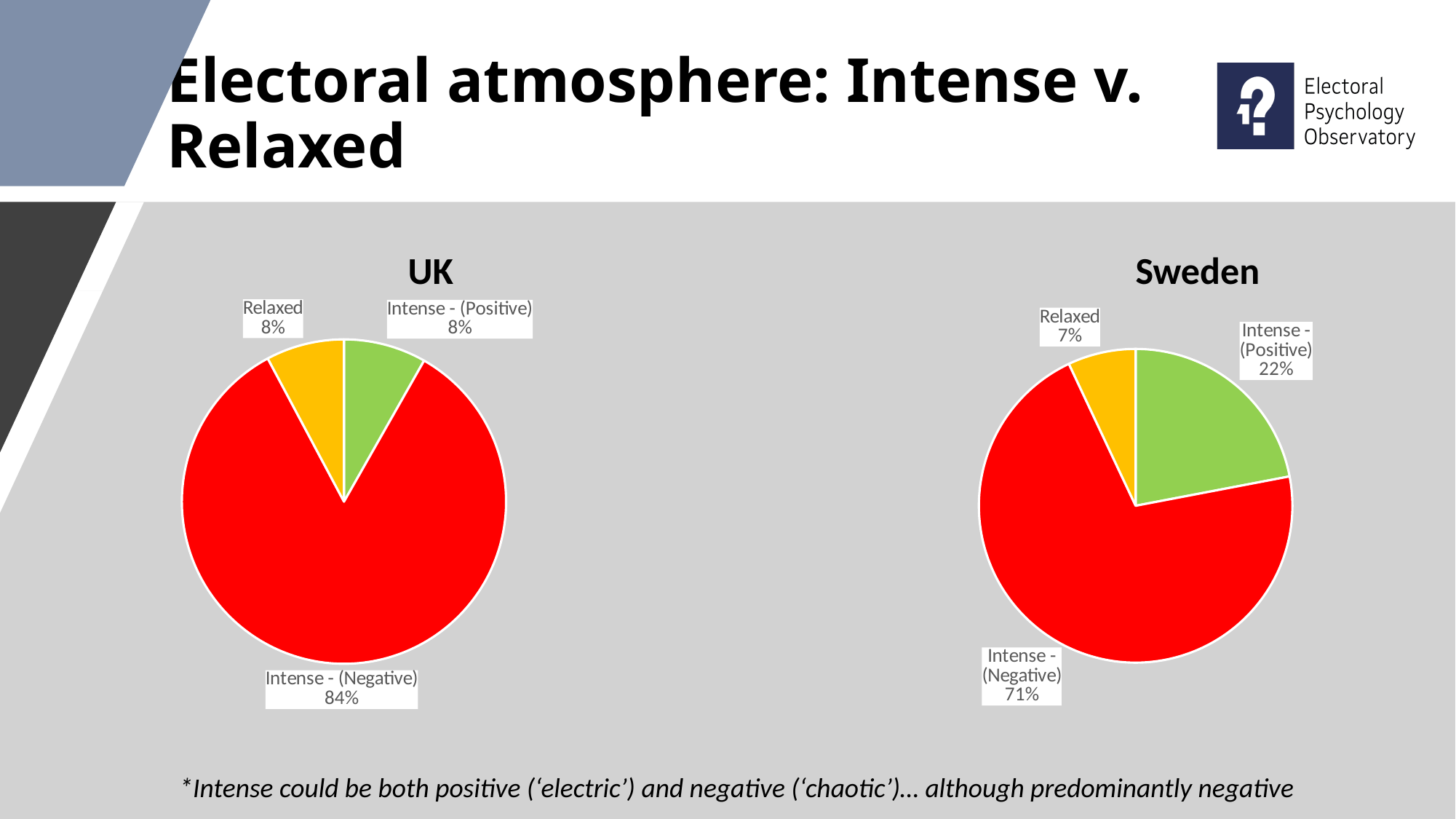
Which chart shows a larger Intense - (Positive) share, UK or Sweden? Sweden In the Sweden pie chart, what is the combined share of Intense - (Positive) and Intense - (Negative)? 93% In the Sweden pie chart, what share is Relaxed? 7% What is the difference between the Intense - (Negative) share in the UK chart and in the Sweden chart? 13% In the UK pie chart, what colour is the Relaxed slice? Yellow How many slices does the Sweden pie chart have? 3 In the Sweden pie chart, which category has the smallest share? Relaxed In the UK pie chart, what share is Intense - (Negative)? 84% In the UK pie chart, which category has the largest share? Intense - (Negative) In the Sweden pie chart, what share is Intense - (Positive)? 22% In the UK pie chart, what share is Relaxed? 8% What type of chart is used for the UK data? Pie chart